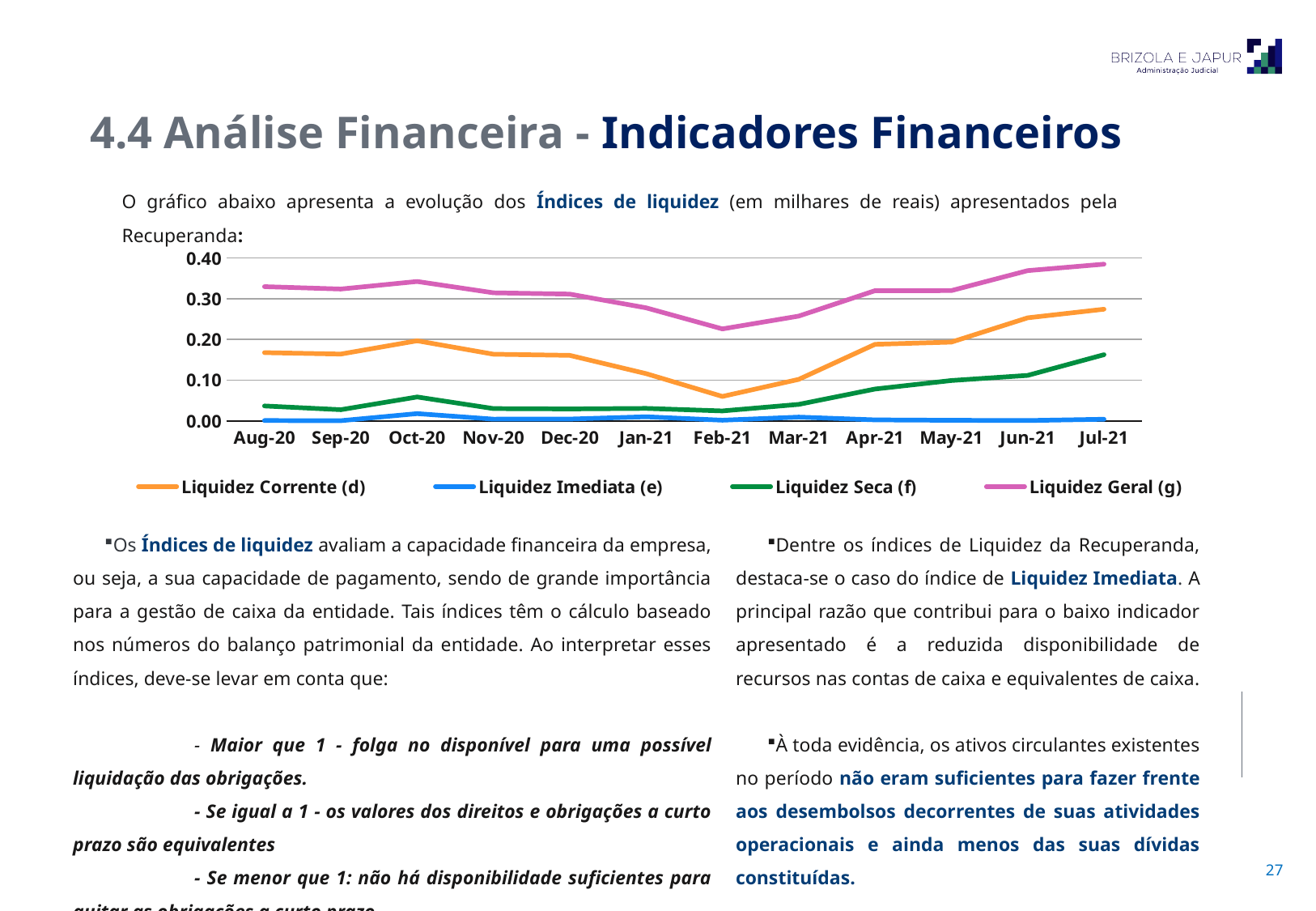
Is the value of Liquidez Geral (g) in Aug-20 greater or less than 0.30? greater Is the value of Liquidez Seca (f) in Jul-21 greater or less than 0.10? greater In which month does Liquidez Geral (g) reach its lowest value? Feb-21 Which is larger in Aug-20, Liquidez Geral (g) or Liquidez Corrente (d)? Liquidez Geral (g) What kind of chart is shown on the slide? Line chart Which series has the lowest values across the whole chart? Liquidez Imediata (e) In which month does Liquidez Corrente (d) reach its highest value? Jul-21 Does Liquidez Geral (g) rise or fall from Feb-21 to Jul-21? Rise How many series does the chart legend list? 4 Which series has the highest values across the whole chart? Liquidez Geral (g) Is the value of Liquidez Corrente (d) in Feb-21 greater or less than 0.10? less How many months are plotted along the x axis of the chart? 12